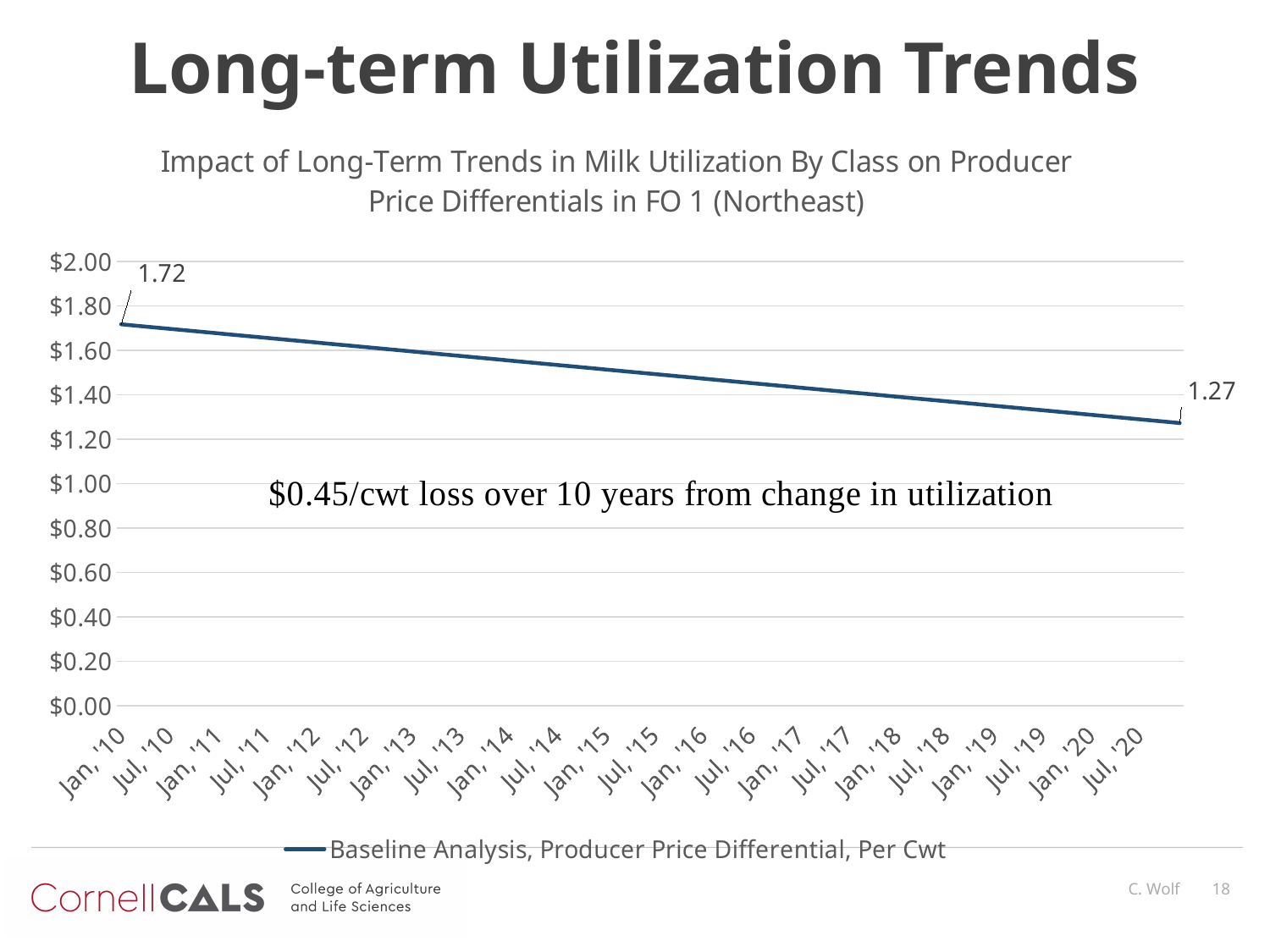
Is the value at Jan '19 greater or less than $1.60? less What is the name of the series shown in the legend? Baseline Analysis, Producer Price Differential, Per Cwt What is the title of the chart? Impact of Long-Term Trends in Milk Utilization By Class on Producer Price Differentials in FO 1 (Northeast) How many series does the legend list? 1 Which is larger, the value at Jan '10 or the value at Jul '20? Jan '10 How many tick labels are shown on the x axis? 22 Is the value at Jan '15 greater or less than $1.40? greater What kind of chart is shown on the slide? line chart Does the Producer Price Differential rise or fall from Jan '10 to Jul '20? fall What is the value of the Producer Price Differential at Jan '10? 1.72